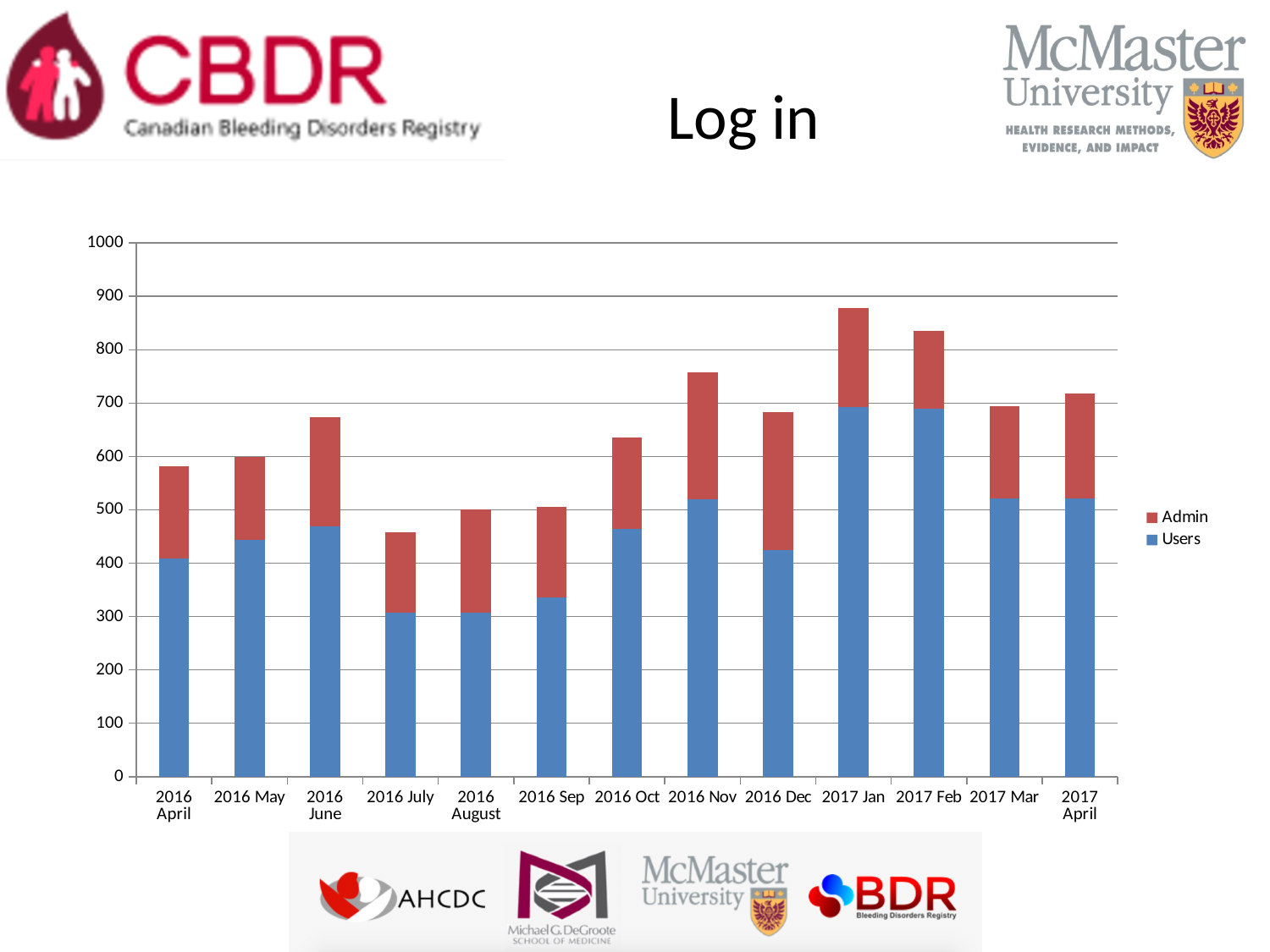
Which has the larger total bar, 2016 Nov or 2016 Dec? 2016 Nov Is the Users value for 2017 Jan greater or less than 600? greater How many months (categories) are shown on the x axis? 13 Which month has the highest total log-in bar? 2017 Jan Which colour represents the Admin series in the legend? red How many series does the legend list? 2 Do the total bars rise or fall from 2016 July to 2017 Jan? rise Which month has the lowest total log-in bar? 2016 July Is the total bar for 2016 July greater or less than 500? less Is the total bar for 2017 Jan greater or less than 800? greater What kind of chart is shown on the slide? stacked bar chart